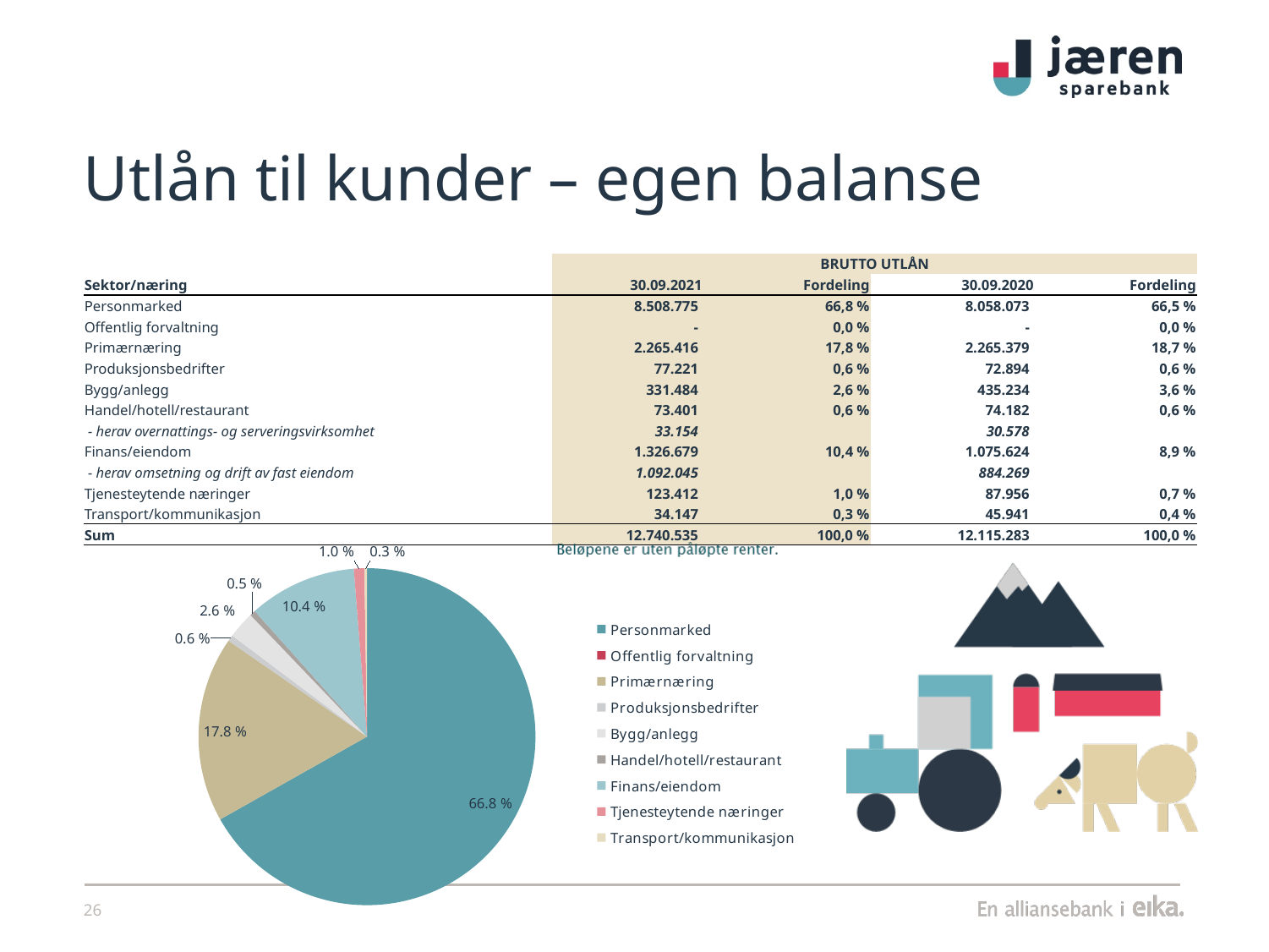
How many percentage points larger is the Personmarked slice than the Primærnæring slice? 49.0 percentage points Which category is listed last in the pie chart's legend? Transport/kommunikasjon Which is larger in the pie chart, Finans/eiendom or Bygg/anlegg? Finans/eiendom How many categories does the pie chart's legend list? 9 What share of the pie does Tjenesteytende næringer have? 1.0 % What kind of chart is shown on the slide? Pie chart Which category has the largest slice of the pie? Personmarked What share of the pie does Personmarked have? 66.8 % What share of the pie does Bygg/anlegg have? 2.6 % Which category is shown in the pie chart's legend directly below Personmarked? Offentlig forvaltning What share of the pie does Primærnæring have? 17.8 % What share of the pie does Finans/eiendom have? 10.4 %